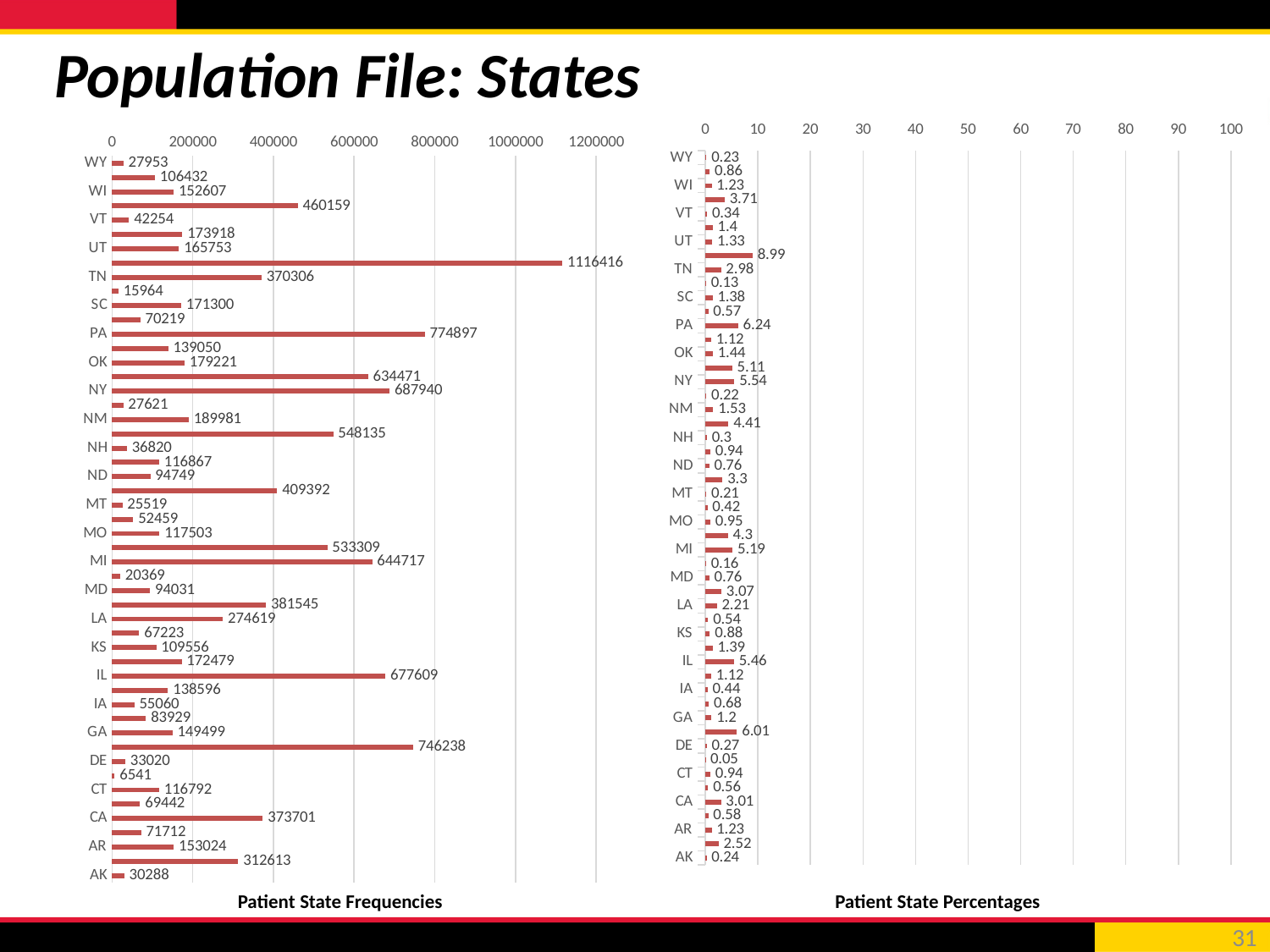
In the Patient State Percentages chart, what is the value for IL? 5.46 In the Patient State Percentages chart, what is the largest value shown on any bar? 8.99 In the Patient State Frequencies chart, what is the largest value shown on any bar? 1116416 In the Patient State Frequencies chart, which is larger, the value for MI or the value for IL? IL In the Patient State Frequencies chart, what is the difference between the values for PA and NY? 86957 In the Patient State Frequencies chart, what is the value for TN? 370306 In the Patient State Percentages chart, what is the value for PA? 6.24 In the Patient State Percentages chart, which is larger, the value for NY or the value for MI? NY In the Patient State Frequencies chart, what is the value for AK? 30288 In the Patient State Frequencies chart, is the value for TN greater or less than 400000? less In the Patient State Frequencies chart, what is the value for PA? 774897 What type of chart is the Patient State Percentages chart? bar chart